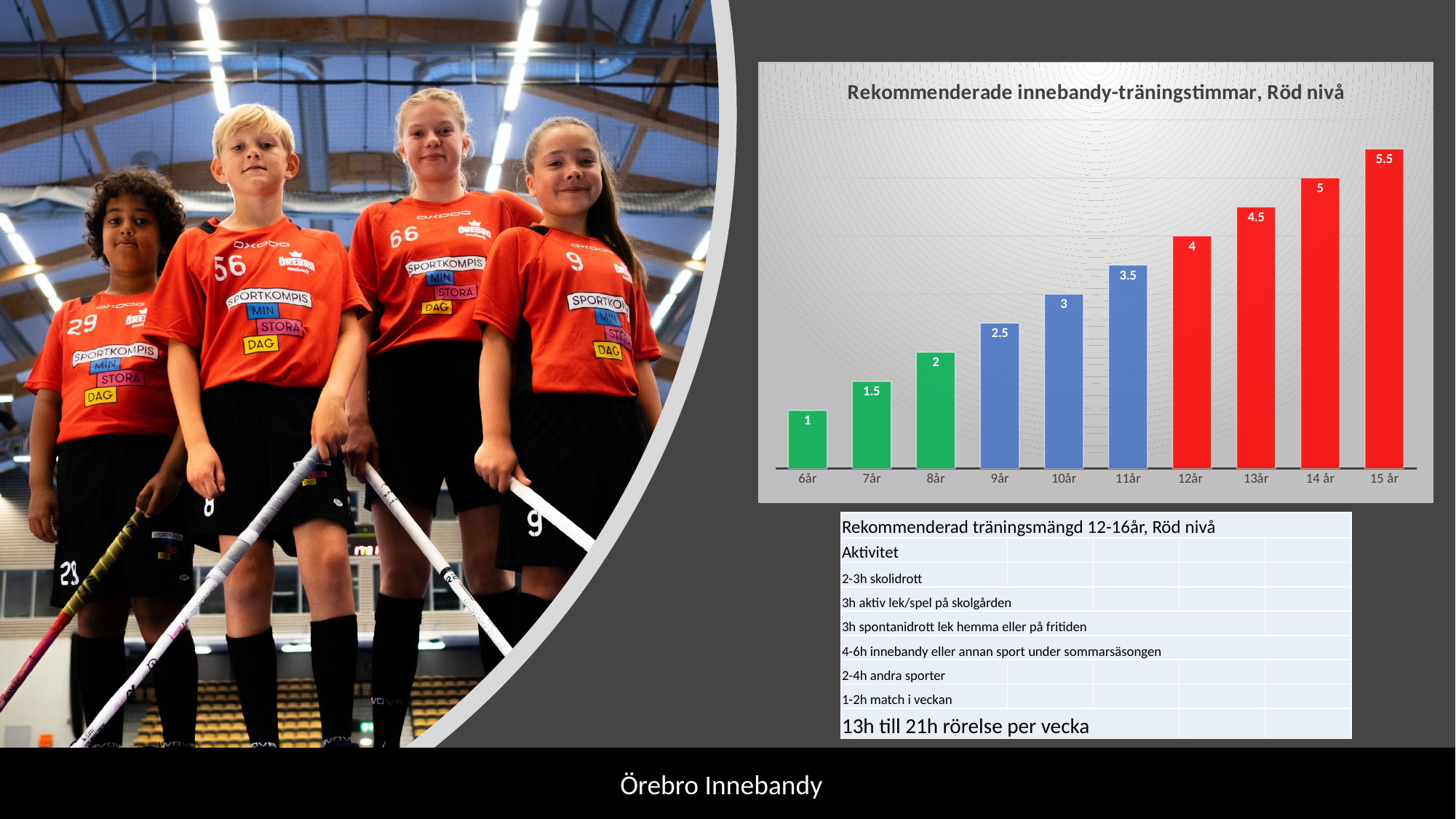
Which is larger, the value for 10år or the value for 8år? 10år How many age categories are shown on the x axis? 10 What is the value for 6år? 1 Which age category has the highest value? 15 år Which age category has the lowest value? 6år What kind of chart is shown? Bar chart What is the value for 9år? 2.5 Do the values rise or fall as age increases along the x axis? Rise What is the value for 13år? 4.5 What is the title of the chart? Rekommenderade innebandy-träningstimmar, Röd nivå What colour are the bars for 12år through 15 år? Red What is the difference between the values for 15 år and 12år? 1.5